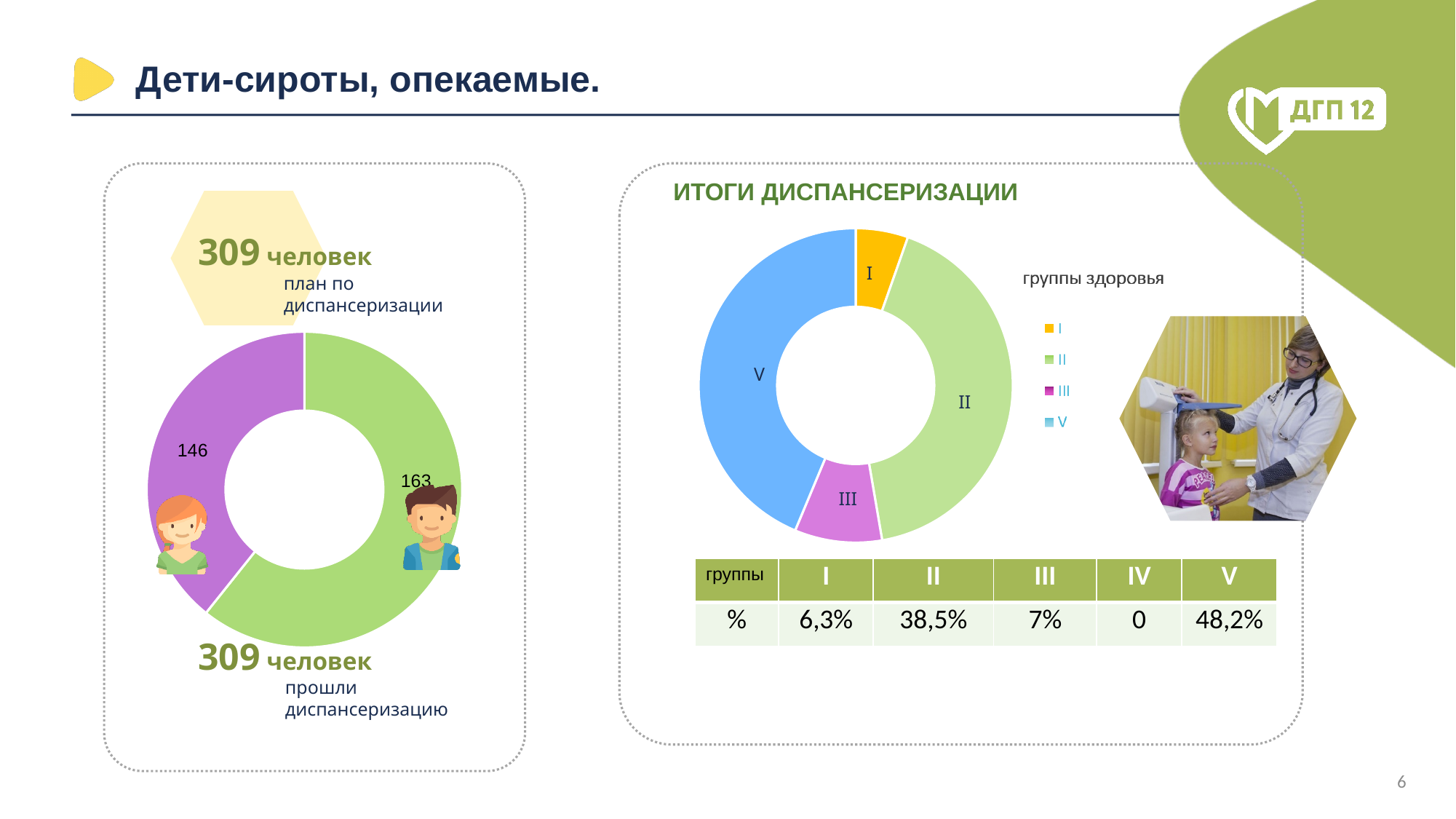
On the left donut chart, what is the value of the purple segment? 146 How many entries does the legend of the 'ИТОГИ ДИСПАНСЕРИЗАЦИИ' chart list? 4 On the 'ИТОГИ ДИСПАНСЕРИЗАЦИИ' chart, what percentage corresponds to health group II? 38,5% On the 'ИТОГИ ДИСПАНСЕРИЗАЦИИ' chart, which health group has the smallest share among the plotted segments? I What type of chart is shown under the heading 'ИТОГИ ДИСПАНСЕРИЗАЦИИ'? donut (pie) chart On the left donut chart, what is the total of the two segments? 309 On the 'ИТОГИ ДИСПАНСЕРИЗАЦИИ' chart, which health group has the largest share? V How many segments does the left donut chart have? 2 On the left donut chart, what is the value of the green segment? 163 On the left donut chart, which segment is larger, the green one or the purple one? green On the left donut chart, what is the difference between the green segment (163) and the purple segment (146)? 17 On the 'ИТОГИ ДИСПАНСЕРИЗАЦИИ' chart, what percentage corresponds to health group V? 48,2%